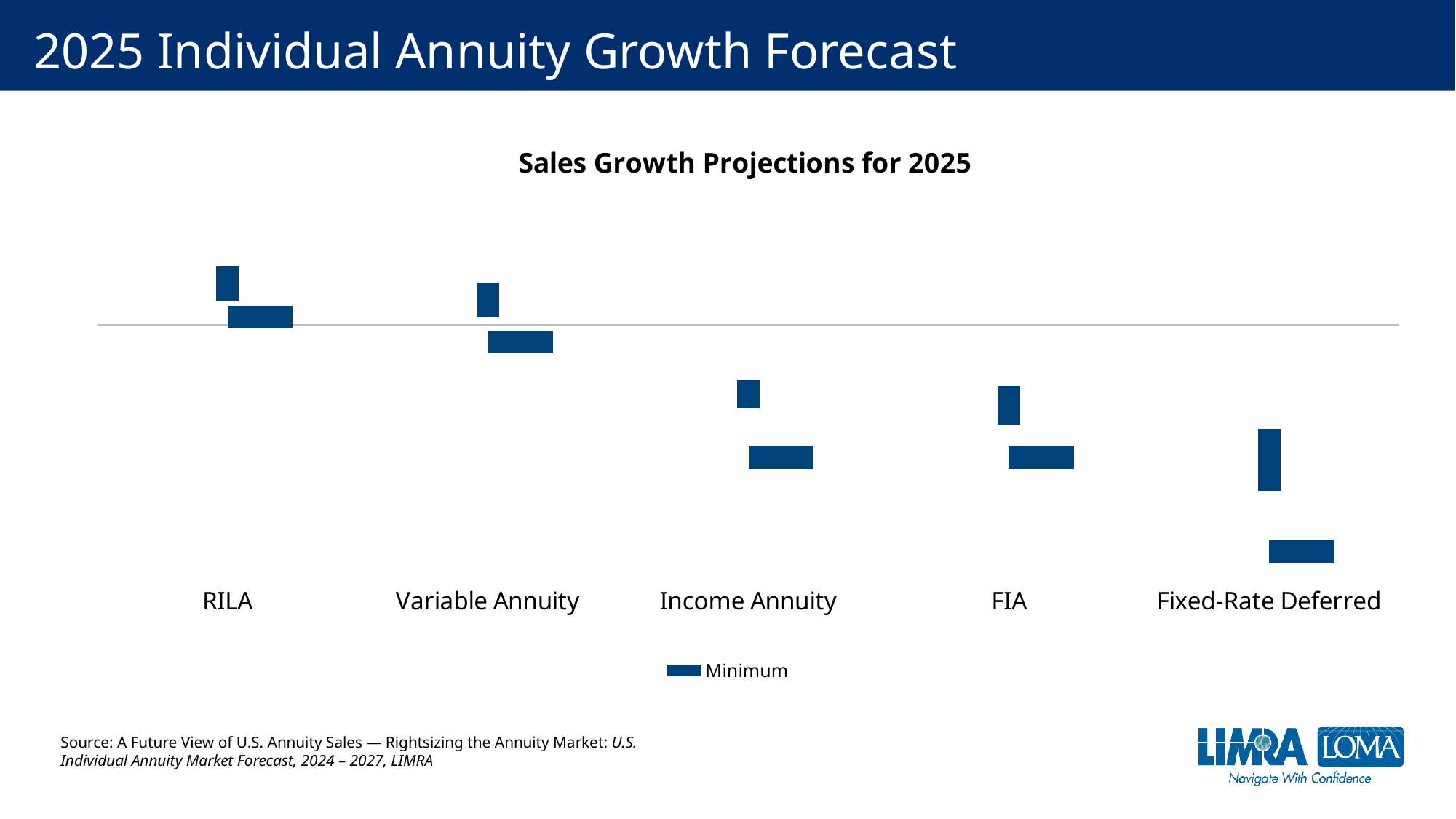
How many annuity categories are shown along the x axis of the chart? 5 What kind of chart is shown on the slide? Bar chart Which category is the last one on the right of the x axis? Fixed-Rate Deferred Which category has the highest bars in the chart? RILA Do the bars rise or fall moving from left to right along the x axis? Fall What is the title of the chart? Sales Growth Projections for 2025 What is the name of the series listed in the chart's legend? Minimum Which category has the lowest bars in the chart? Fixed-Rate Deferred Which category is plotted higher in the chart, Variable Annuity or FIA? Variable Annuity How many series does the chart's legend list? 1 Which category is plotted higher in the chart, RILA or Fixed-Rate Deferred? RILA